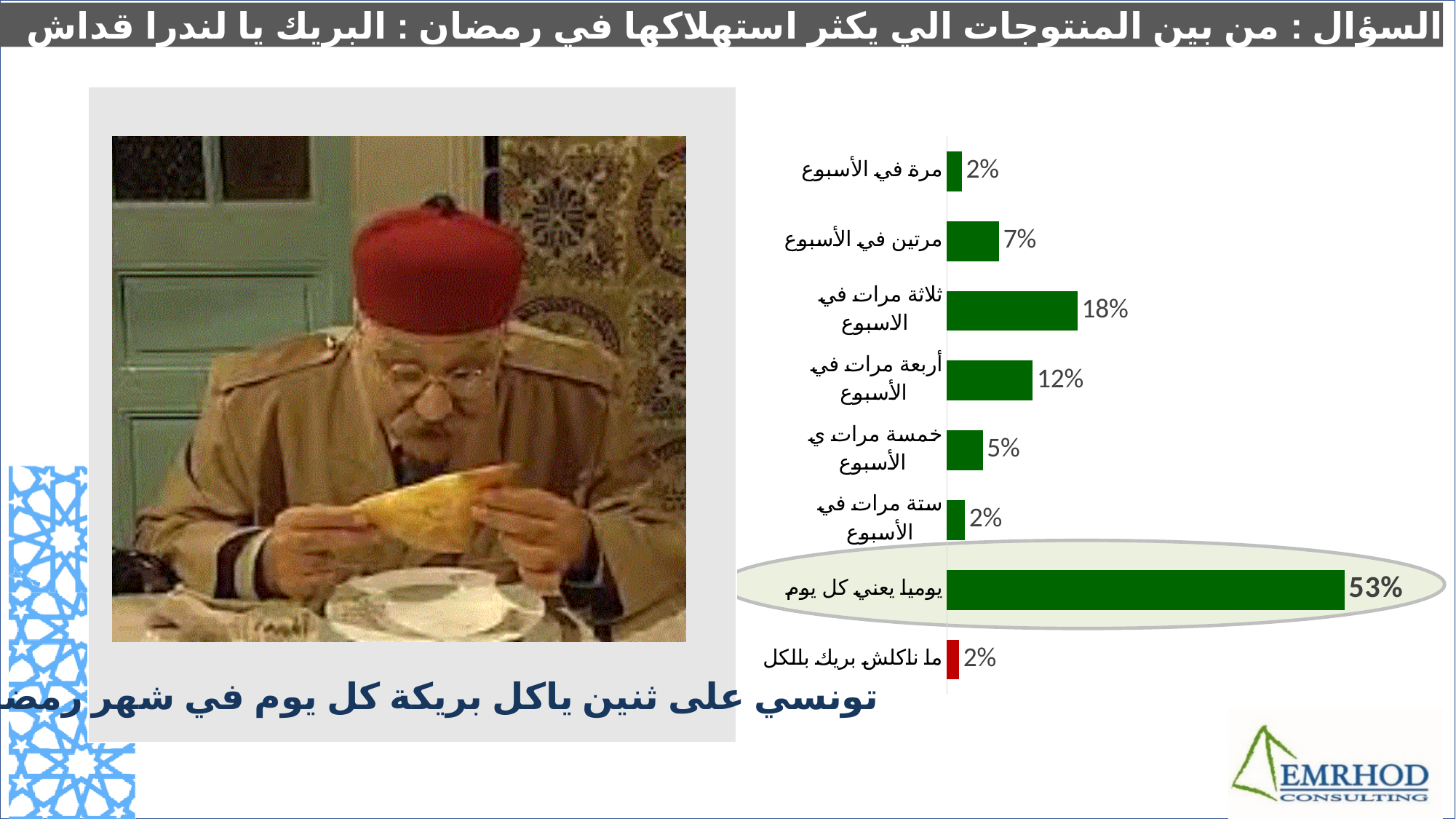
Which bar is shown in a different colour (red) from the others? ما ناكلش بريك بالكل What is the difference between the values for "يوميا يعني كل يوم" and "ثلاثة مرات في الاسبوع"? 35% Which is larger, the value for "مرتين في الأسبوع" or the value for "خمسة مرات في الأسبوع"? مرتين في الأسبوع What is the value for "مرتين في الأسبوع" (twice a week)? 7% Which category has the highest value? يوميا يعني كل يوم What is the difference between the values for "ثلاثة مرات في الاسبوع" and "أربعة مرات في الأسبوع"? 6% What is the value for "ما ناكلش بريك بالكل" (don't eat brik at all)? 2% What is the value for "أربعة مرات في الأسبوع" (four times a week)? 12% What kind of chart is shown on the slide? Bar chart How many categories does the chart show? 8 What is the value for "يوميا يعني كل يوم" (daily)? 53% What is the value for "ثلاثة مرات في الاسبوع" (three times a week)? 18%